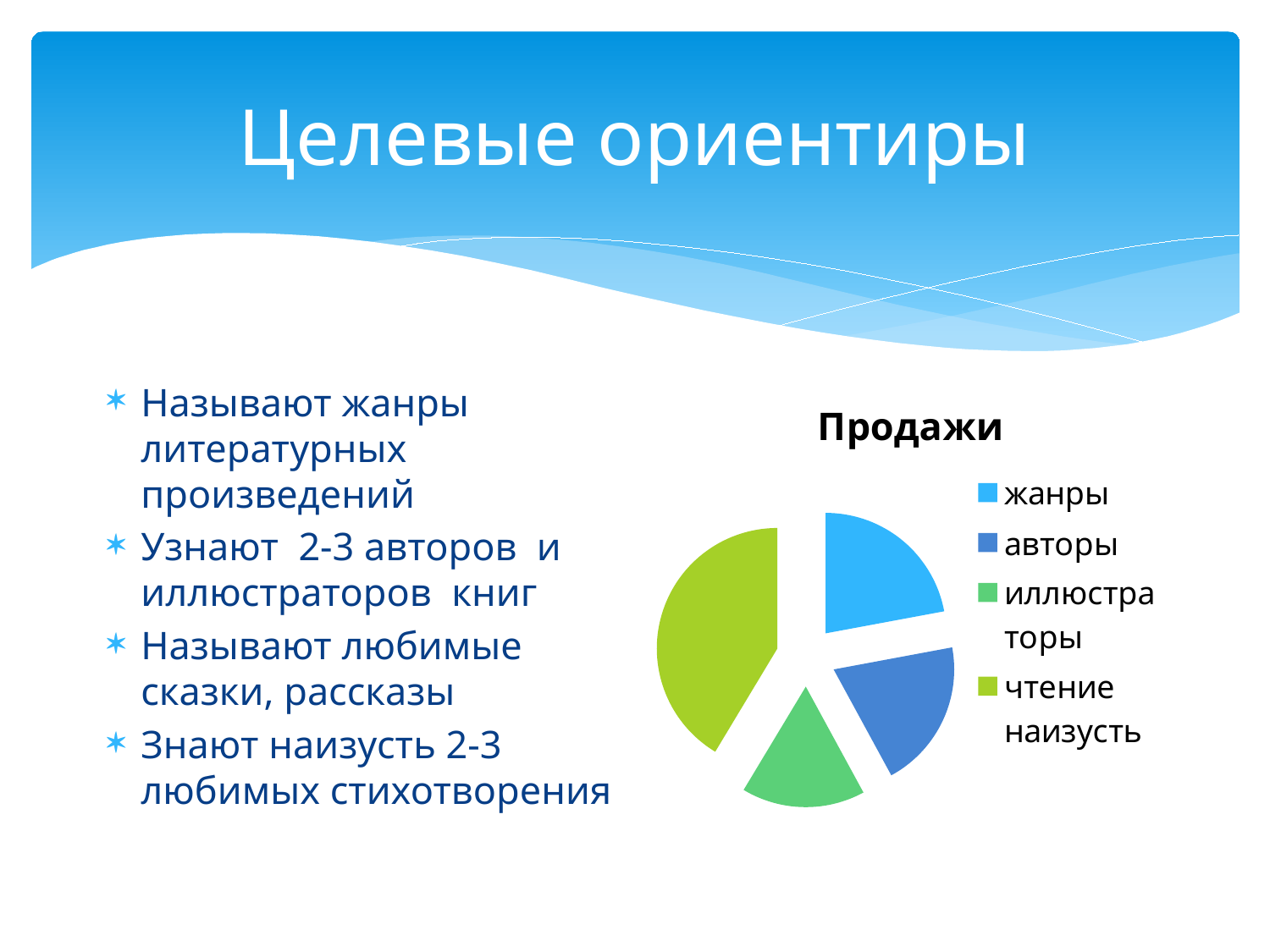
What is the title of the chart on the slide? Продажи Which category has the largest slice in the pie chart? чтение наизусть Which slice is larger, чтение наизусть or иллюстраторы? чтение наизусть What kind of chart is shown on the slide? pie chart Which slice is larger, чтение наизусть or авторы? чтение наизусть Which category is shown in light green (lime) in the pie chart? чтение наизусть Which slice is larger, чтение наизусть or жанры? чтение наизусть How many entries does the chart's legend list? 4 How many slices does the pie chart have? 4